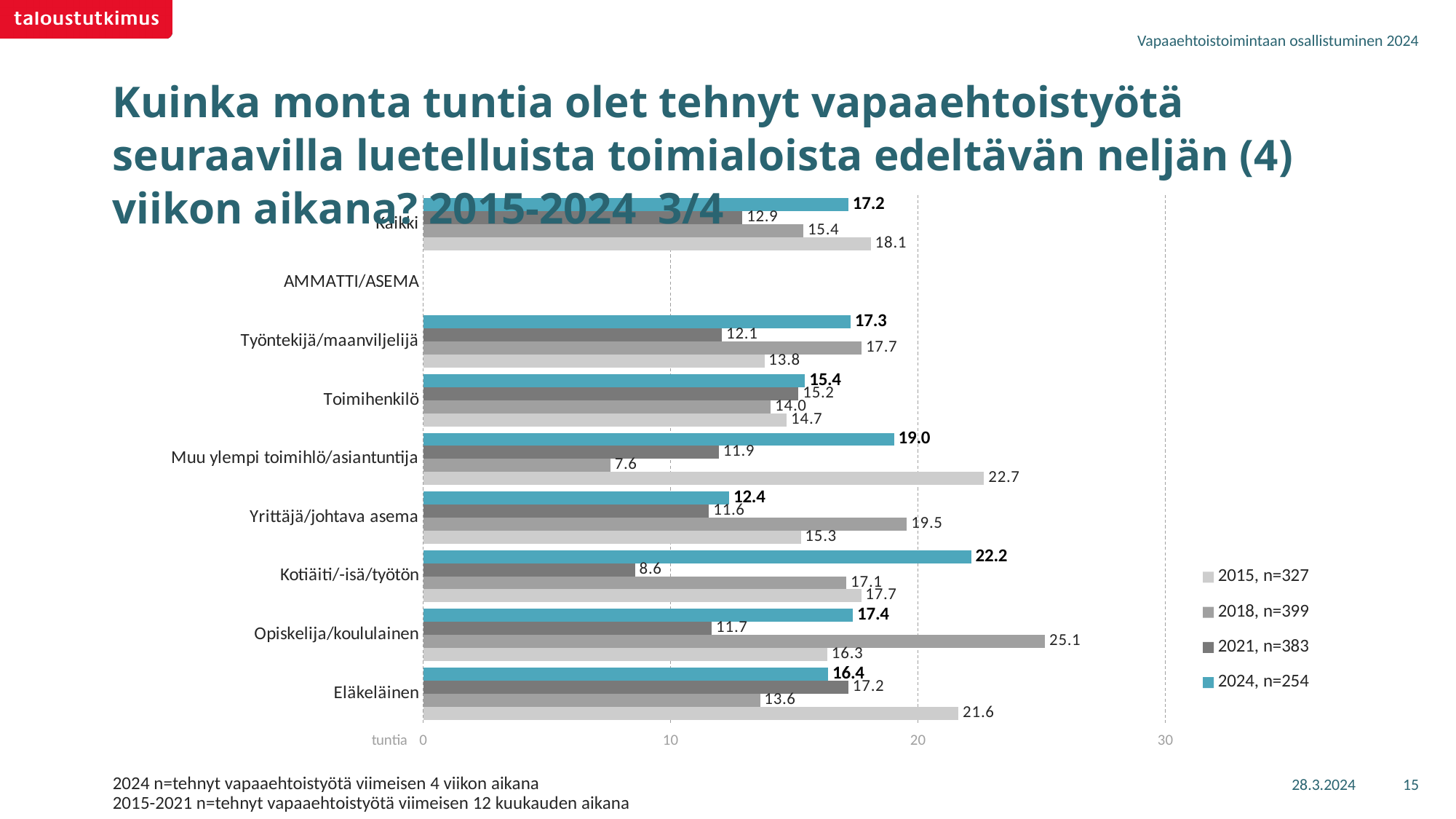
What sample size (n) does the legend give for the 2024 series? n=254 What is the 2021 value for Kaikki? 12.9 Which category has the lowest 2018 value? Muu ylempi toimihlö/asiantuntija Which category has the lowest 2024 value? Yrittäjä/johtava asema What is the 2018 value for Opiskelija/koululainen? 25.1 For Eläkeläinen, which is larger: the 2015 value or the 2024 value? 2015 What is the difference between the 2015 and 2018 values for Muu ylempi toimihlö/asiantuntija? 15.1 What kind of chart is shown on the slide? bar chart Which category has the highest 2024 value? Kotiäiti/-isä/työtön How many series does the legend list? 4 What is the 2024 value for Kotiäiti/-isä/työtön? 22.2 Is the 2018 value for Opiskelija/koululainen greater or less than 20? greater